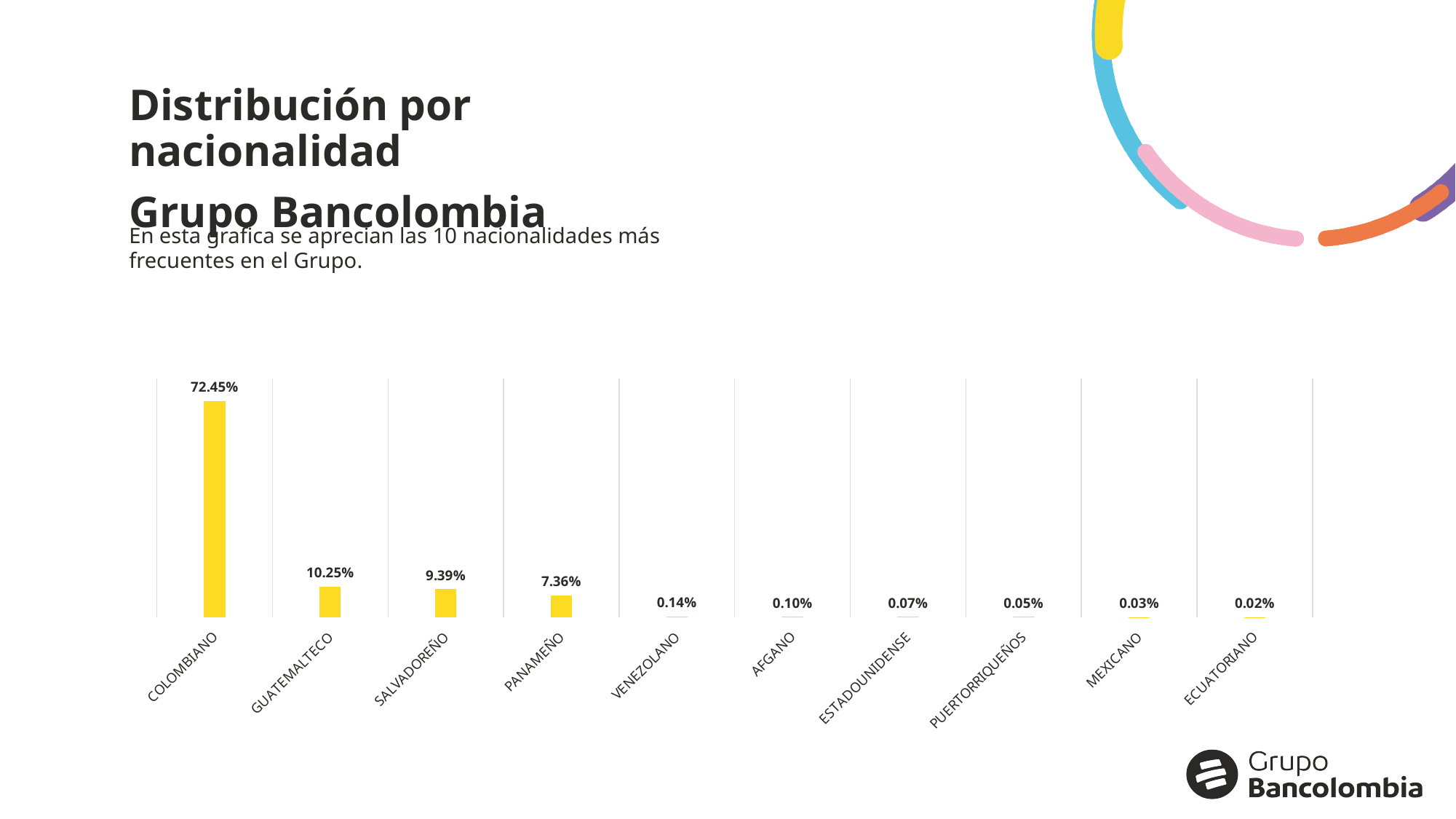
What is the value for GUATEMALTECO? 10.25% Which nationality has the lowest value? ECUATORIANO What is the value for ECUATORIANO? 0.02% How many nationalities are shown in the chart? 10 Which is larger, the value for PANAMEÑO or the value for AFGANO? PANAMEÑO What is the value for VENEZOLANO? 0.14% What is the value for SALVADOREÑO? 9.39% Do the values rise or fall from left to right along the x axis? Fall Which nationality has the highest value? COLOMBIANO What is the difference between the values for GUATEMALTECO and SALVADOREÑO? 0.86% What is the value for COLOMBIANO? 72.45% What kind of chart is shown on the slide? Bar chart